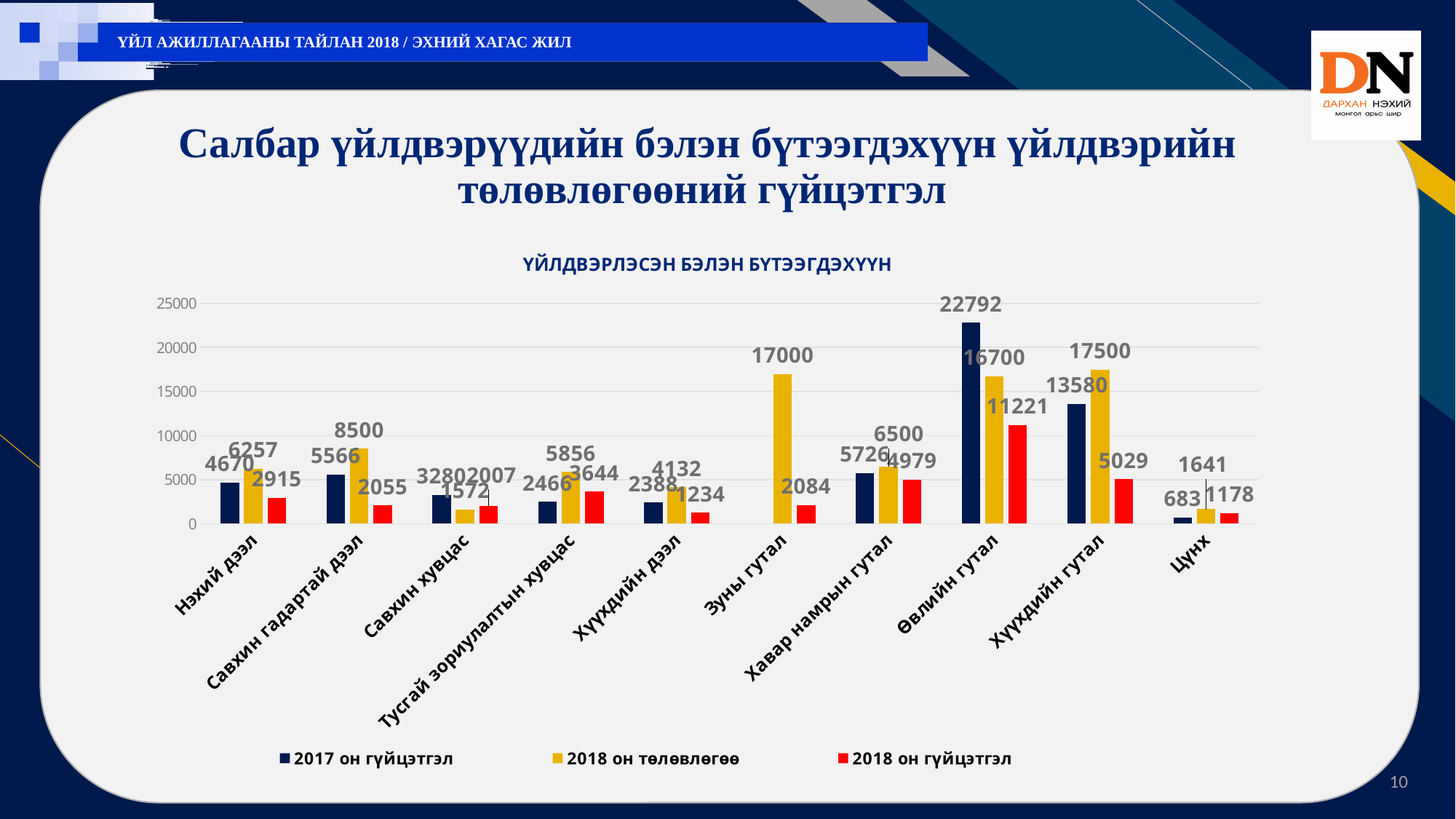
Which category has the lowest 2017 он гүйцэтгэл value? Цүнх What is the 2018 он гүйцэтгэл value for Цүнх? 1178 Which category has the highest 2018 он гүйцэтгэл value? Өвлийн гутал Which category has the highest 2017 он гүйцэтгэл value? Өвлийн гутал What is the 2018 он төлөвлөгөө value for Зуны гутал? 17000 How many categories are shown on the x axis of the chart? 10 For Савхин хувцас, which is larger: the 2017 он гүйцэтгэл value or the 2018 он төлөвлөгөө value? 2017 он гүйцэтгэл What is the 2018 он төлөвлөгөө value for Савхин гадартай дээл? 8500 What is the 2017 он гүйцэтгэл value for Өвлийн гутал? 22792 How many series does the legend list? 3 What is the difference between the 2017 он гүйцэтгэл and 2018 он гүйцэтгэл values for Өвлийн гутал? 11571 What is the difference between the 2018 он төлөвлөгөө and 2018 он гүйцэтгэл values for Хүүхдийн гутал? 12471